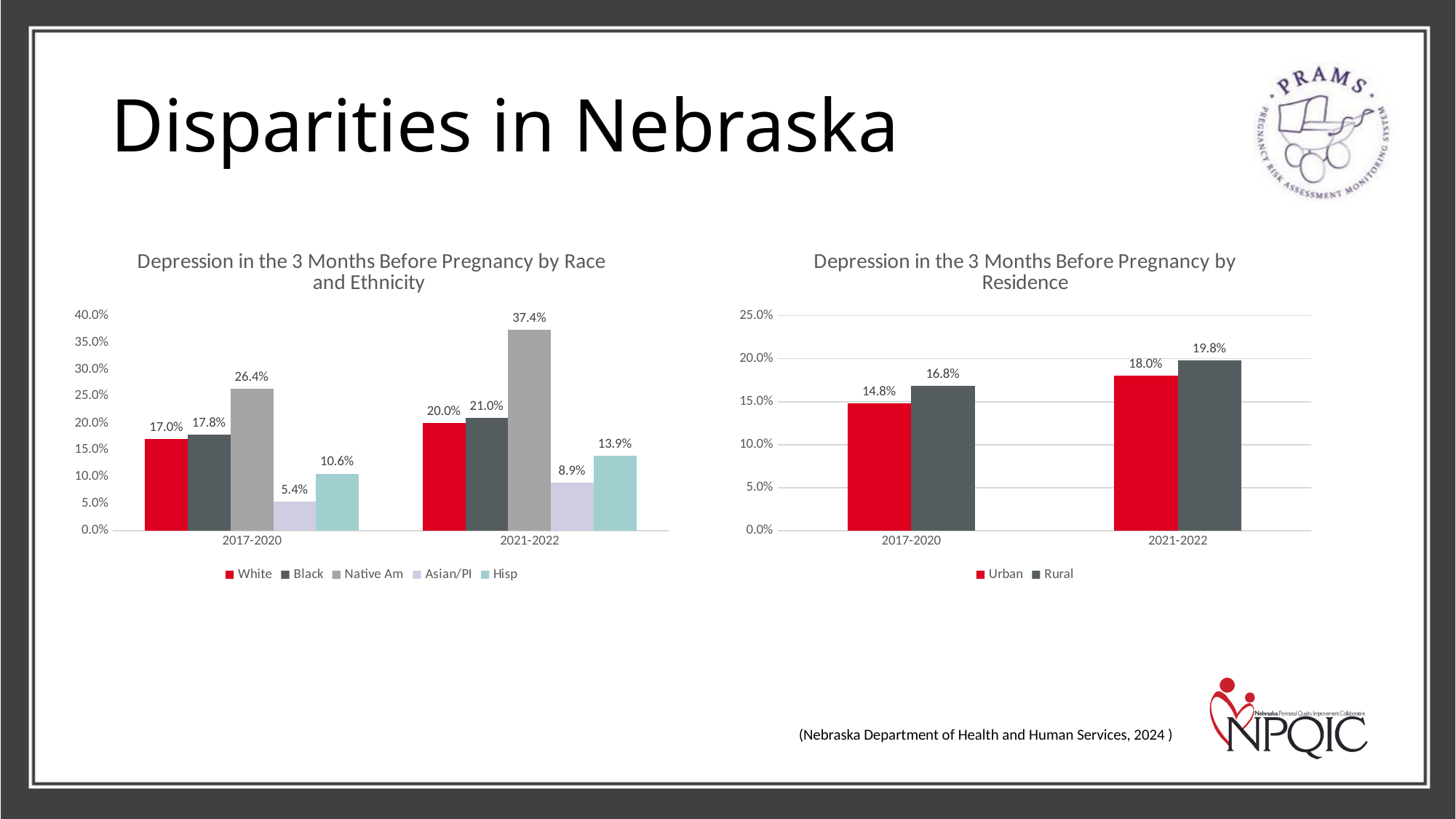
In the 'Depression in the 3 Months Before Pregnancy by Residence' chart, do the Urban values rise or fall from 2017-2020 to 2021-2022? rise In the 'Depression in the 3 Months Before Pregnancy by Race and Ethnicity' chart, which group has the lowest value in 2021-2022? Asian/PI In the 'Depression in the 3 Months Before Pregnancy by Race and Ethnicity' chart, what is the value for Asian/PI in 2017-2020? 5.4% In the 'Depression in the 3 Months Before Pregnancy by Race and Ethnicity' chart, which group has the highest value in 2017-2020? Native Am In the 'Depression in the 3 Months Before Pregnancy by Residence' chart, is Urban or Rural larger in 2021-2022? Rural What kind of chart is the 'Depression in the 3 Months Before Pregnancy by Residence' chart? bar chart In the 'Depression in the 3 Months Before Pregnancy by Race and Ethnicity' chart, how many series does the legend list? 5 In the 'Depression in the 3 Months Before Pregnancy by Residence' chart, what is the difference between Rural and Urban in 2017-2020? 2.0% In the 'Depression in the 3 Months Before Pregnancy by Residence' chart, what is the value for Rural in 2021-2022? 19.8% In the 'Depression in the 3 Months Before Pregnancy by Residence' chart, what is the value for Urban in 2017-2020? 14.8% In the 'Depression in the 3 Months Before Pregnancy by Race and Ethnicity' chart, what is the difference between the Native Am values for 2021-2022 and 2017-2020? 11.0% In the 'Depression in the 3 Months Before Pregnancy by Race and Ethnicity' chart, what is the value for Native Am in 2021-2022? 37.4%